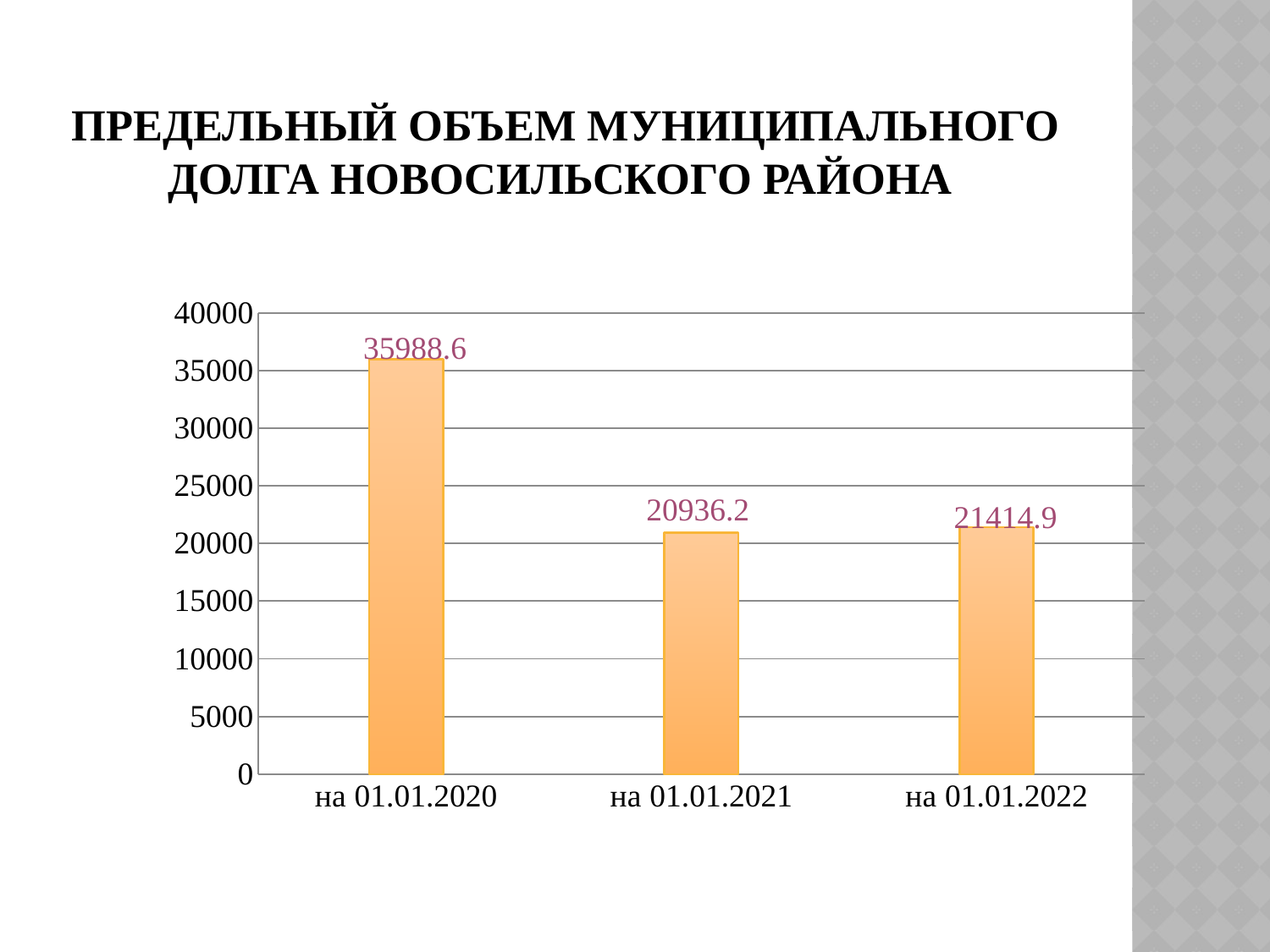
What is the value for на 01.01.2022? 21414.9 What is the difference between the values for на 01.01.2022 and на 01.01.2021? 478.7 What is the title of the slide? ПРЕДЕЛЬНЫЙ ОБЪЕМ МУНИЦИПАЛЬНОГО ДОЛГА НОВОСИЛЬСКОГО РАЙОНА What kind of chart is shown on the slide? bar chart What is the value for на 01.01.2021? 20936.2 What is the value for на 01.01.2020? 35988.6 Is the value for на 01.01.2021 greater or less than 25000? less Which category has the highest value? на 01.01.2020 Which is larger, the value for на 01.01.2020 or the value for на 01.01.2022? на 01.01.2020 Which category has the lowest value? на 01.01.2021 How many categories are shown on the x axis? 3 What is the difference between the values for на 01.01.2020 and на 01.01.2021? 15052.4